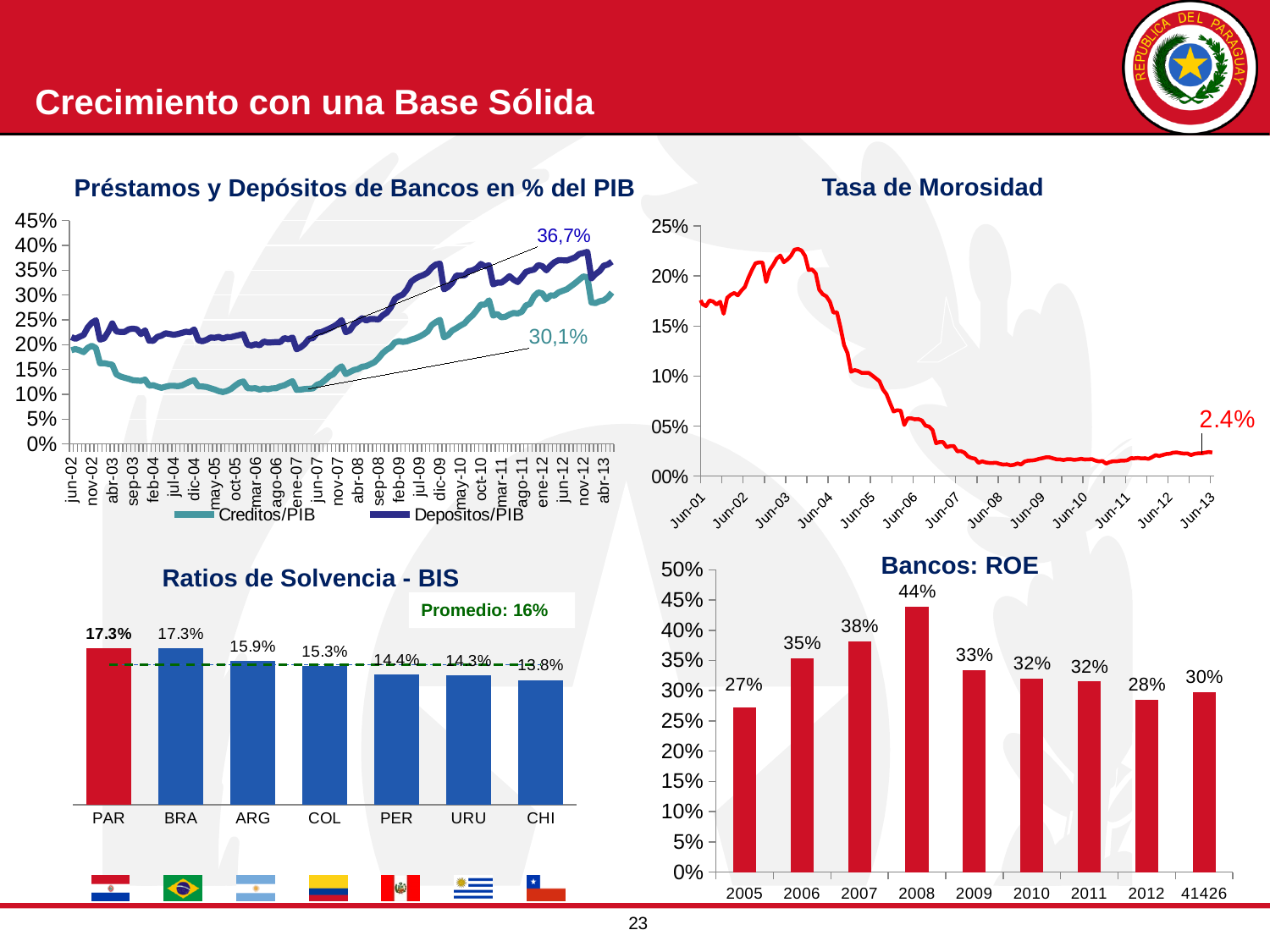
In the 'Bancos: ROE' chart, how many bars are plotted? 9 In the 'Bancos: ROE' chart, what is the difference between the ROE in 2008 and the ROE in 2005? 17% In the 'Préstamos y Depósitos de Bancos en % del PIB' chart, what is the final labelled value for Depositos/PIB? 36,7% In the 'Ratios de Solvencia - BIS' chart, what is the value for COL? 15.3% In the 'Préstamos y Depósitos de Bancos en % del PIB' chart, how many series does the legend list? 2 In the 'Bancos: ROE' chart, which year has the lowest ROE? 2005 In the 'Ratios de Solvencia - BIS' chart, is the value for ARG larger or smaller than the value for PER? larger In the 'Bancos: ROE' chart, what is the ROE value for 2008? 44% In the 'Tasa de Morosidad' chart, what is the value labelled at the end of the line (Jun-13)? 2.4% In the 'Ratios de Solvencia - BIS' chart, which country has the lowest solvency ratio? CHI In the 'Tasa de Morosidad' chart, does the line generally rise or fall from Jun-03 to Jun-13? fall In the 'Ratios de Solvencia - BIS' chart, what average (Promedio) value is shown? 16%